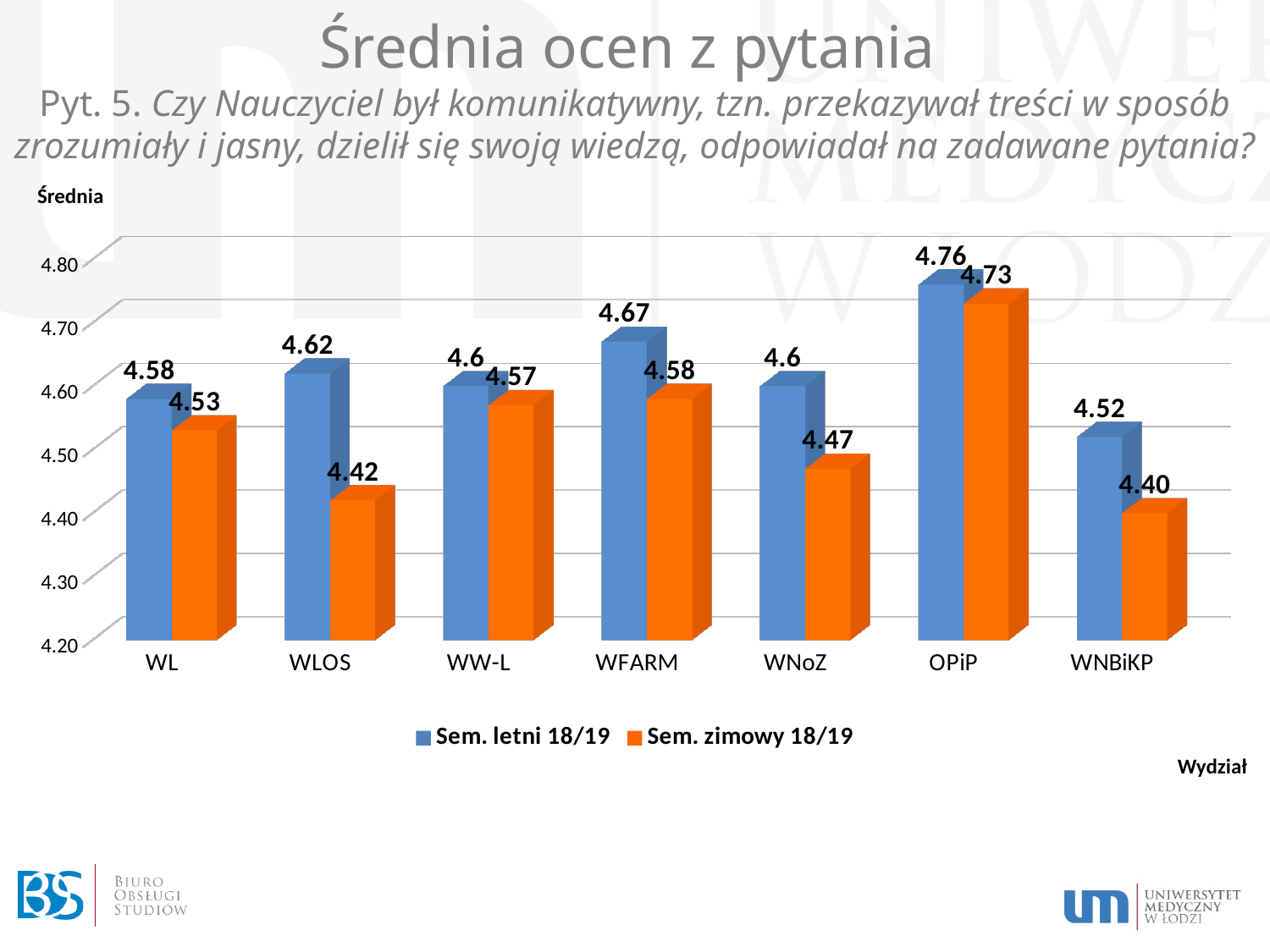
How many categories are shown on the x axis? 7 Is the Sem. zimowy 18/19 value for OPiP greater or less than 4.70? greater How many series does the legend list? 2 What is the value for WNBiKP in the Sem. zimowy 18/19 series? 4.40 What is the value for WFARM in the Sem. letni 18/19 series? 4.67 Which is larger for WNoZ: the Sem. letni 18/19 value or the Sem. zimowy 18/19 value? Sem. letni 18/19 Which category has the highest value in the Sem. letni 18/19 series? OPiP What is the value for WLOS in the Sem. zimowy 18/19 series? 4.42 Which category has the lowest value in the Sem. zimowy 18/19 series? WNBiKP What is the difference between the Sem. letni 18/19 and Sem. zimowy 18/19 values for WLOS? 0.20 Which colour represents the Sem. zimowy 18/19 series? orange What kind of chart is shown on the slide? bar chart